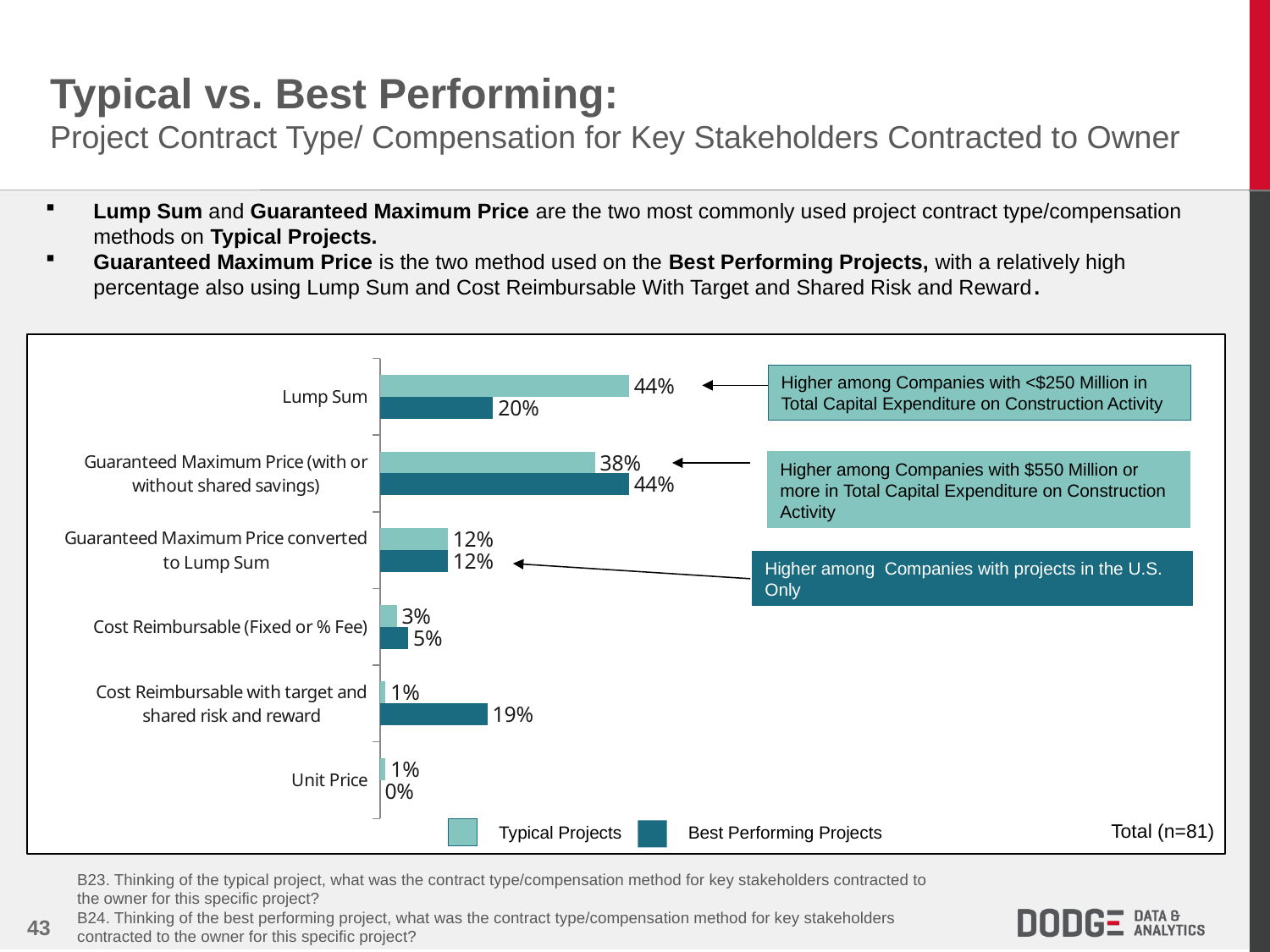
What is the value for Cost Reimbursable with target and shared risk and reward in the Best Performing Projects series? 19% How many series does the legend list? 2 Which category has the highest value in the Best Performing Projects series? Guaranteed Maximum Price (with or without shared savings) What kind of chart is shown on the slide? Bar chart Which is larger for Guaranteed Maximum Price (with or without shared savings): the Typical Projects value or the Best Performing Projects value? Best Performing Projects How many categories are shown on the chart? 6 What is the value for Lump Sum in the Typical Projects series? 44% Which category has the lowest value in the Best Performing Projects series? Unit Price What is the difference between the Typical Projects and Best Performing Projects values for Lump Sum? 24% What is the value for Unit Price in the Best Performing Projects series? 0% What is the sample size shown on the chart? n=81 What is the value for Cost Reimbursable (Fixed or % Fee) in the Typical Projects series? 3%